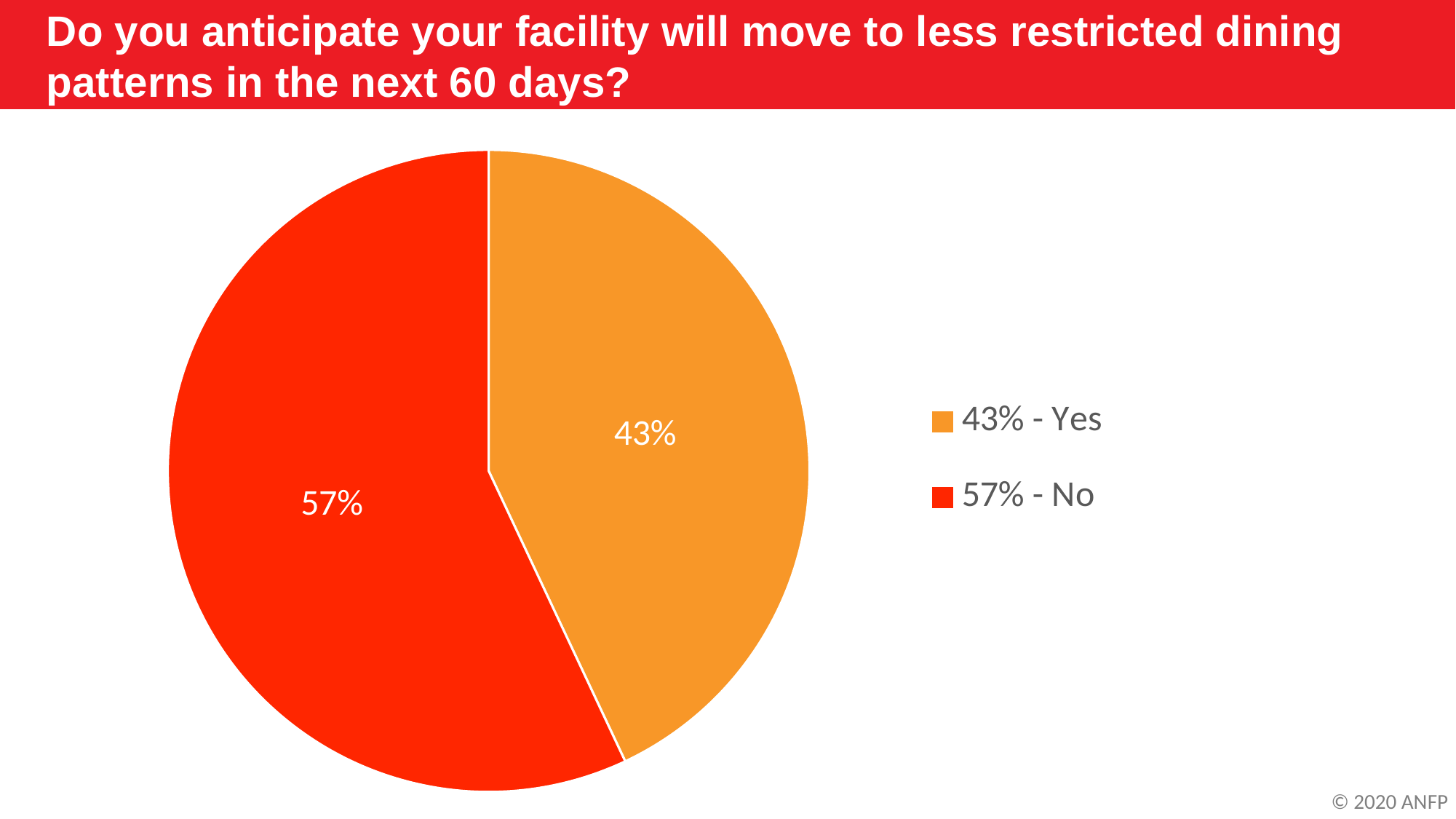
What is the difference in percentage points between the No and Yes slices? 14 How many slices does the pie chart have? 2 Is the share for Yes larger or smaller than the share for No? smaller What share of the pie does the No slice represent? 57% What percentage of respondents answered No? 57% What percentage of respondents answered Yes? 43% Which response has the larger share of the pie? No What kind of chart is shown on the slide? pie chart What colour is the Yes slice? orange How many entries does the legend list? 2 Which response has the smaller share of the pie? Yes What question does the chart title ask? Do you anticipate your facility will move to less restricted dining patterns in the next 60 days?